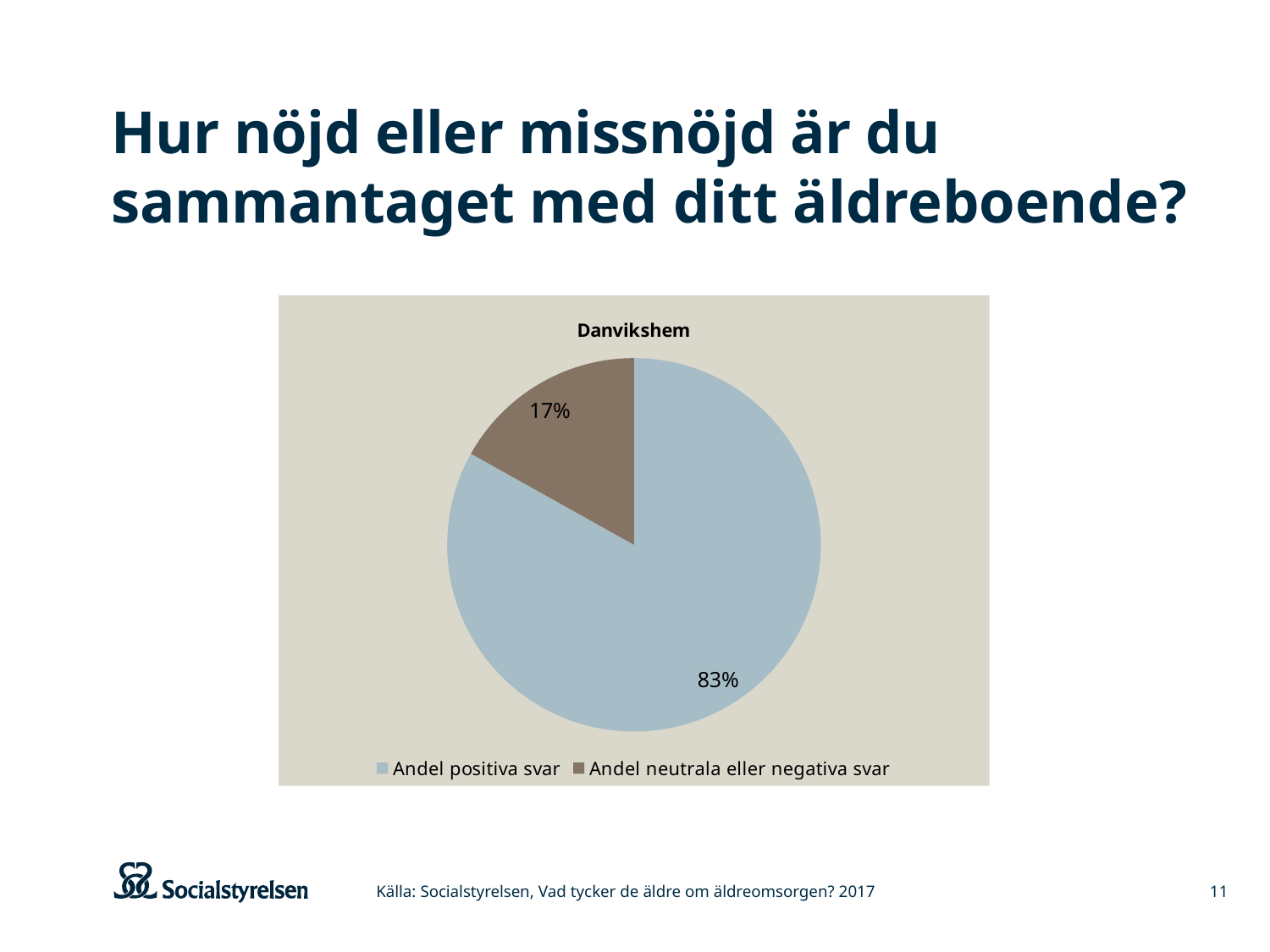
What is the title of the chart? Danvikshem What share of the pie is 'Andel positiva svar'? 83% What kind of chart is shown on the slide? Pie chart What colour is the 'Andel neutrala eller negativa svar' slice? Brown What is the difference in percentage points between 'Andel positiva svar' and 'Andel neutrala eller negativa svar'? 66 percentage points Which is larger: 'Andel positiva svar' or 'Andel neutrala eller negativa svar'? Andel positiva svar Which slice is the smallest in the pie chart? Andel neutrala eller negativa svar How many slices does the pie chart have? 2 What share of the pie is 'Andel neutrala eller negativa svar'? 17% Which slice is the largest in the pie chart? Andel positiva svar How many entries does the legend list? 2